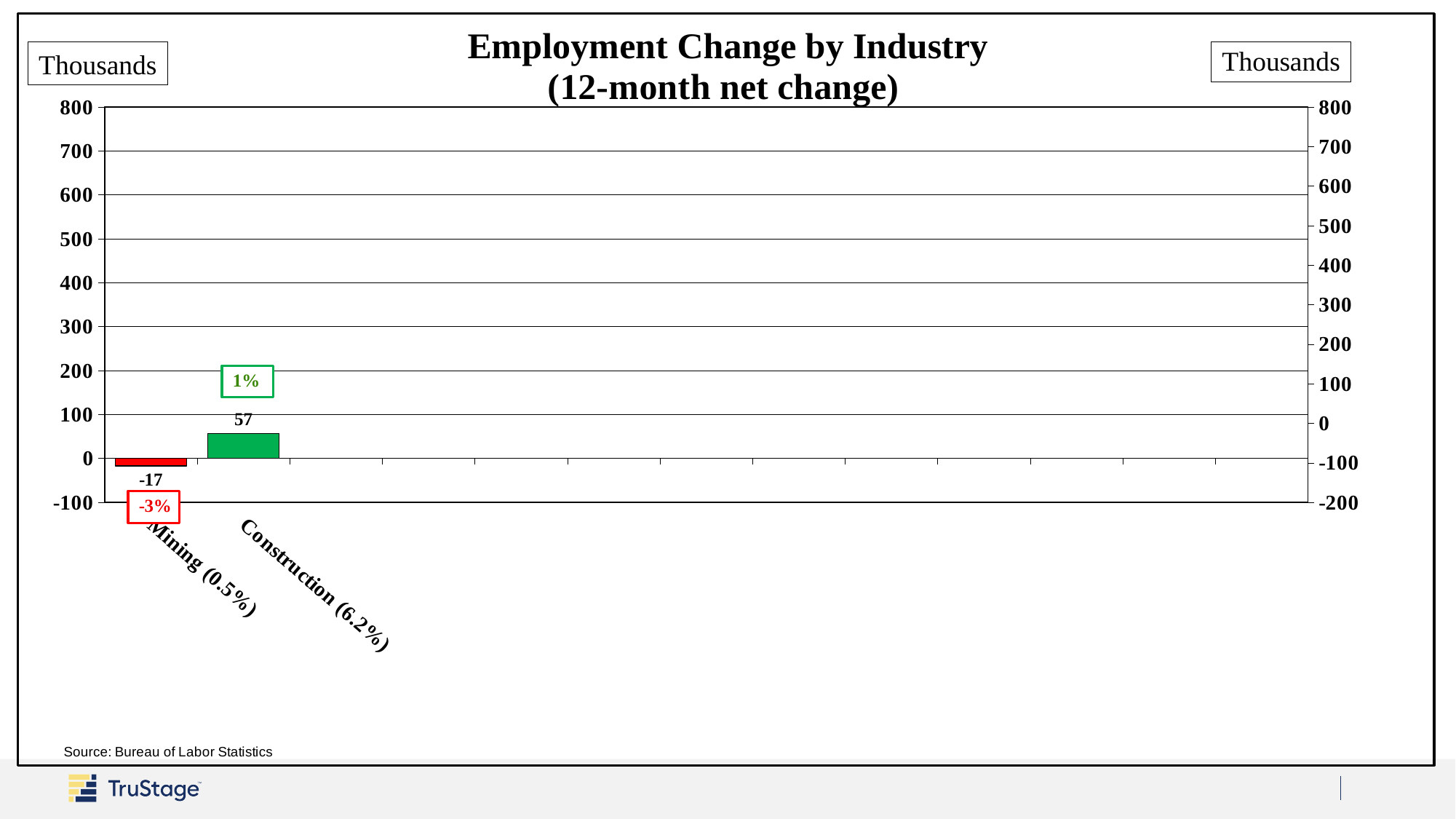
What is the value for Construction (6.2%)? 57 Which category has the highest value? Construction (6.2%) What kind of chart is shown on the slide? bar chart What percentage label is shown in the box above the Construction (6.2%) bar? 1% Is the value for Construction (6.2%) greater or less than 100? less Is the value for Mining (0.5%) greater or less than 0? less Which is larger, the value for Mining (0.5%) or the value for Construction (6.2%)? Construction (6.2%) What is the difference between the values for Construction (6.2%) and Mining (0.5%)? 74 Which category has the lowest value? Mining (0.5%) What is the value for Mining (0.5%)? -17 What is the title of the chart? Employment Change by Industry (12-month net change) How many bars are plotted on the chart? 2